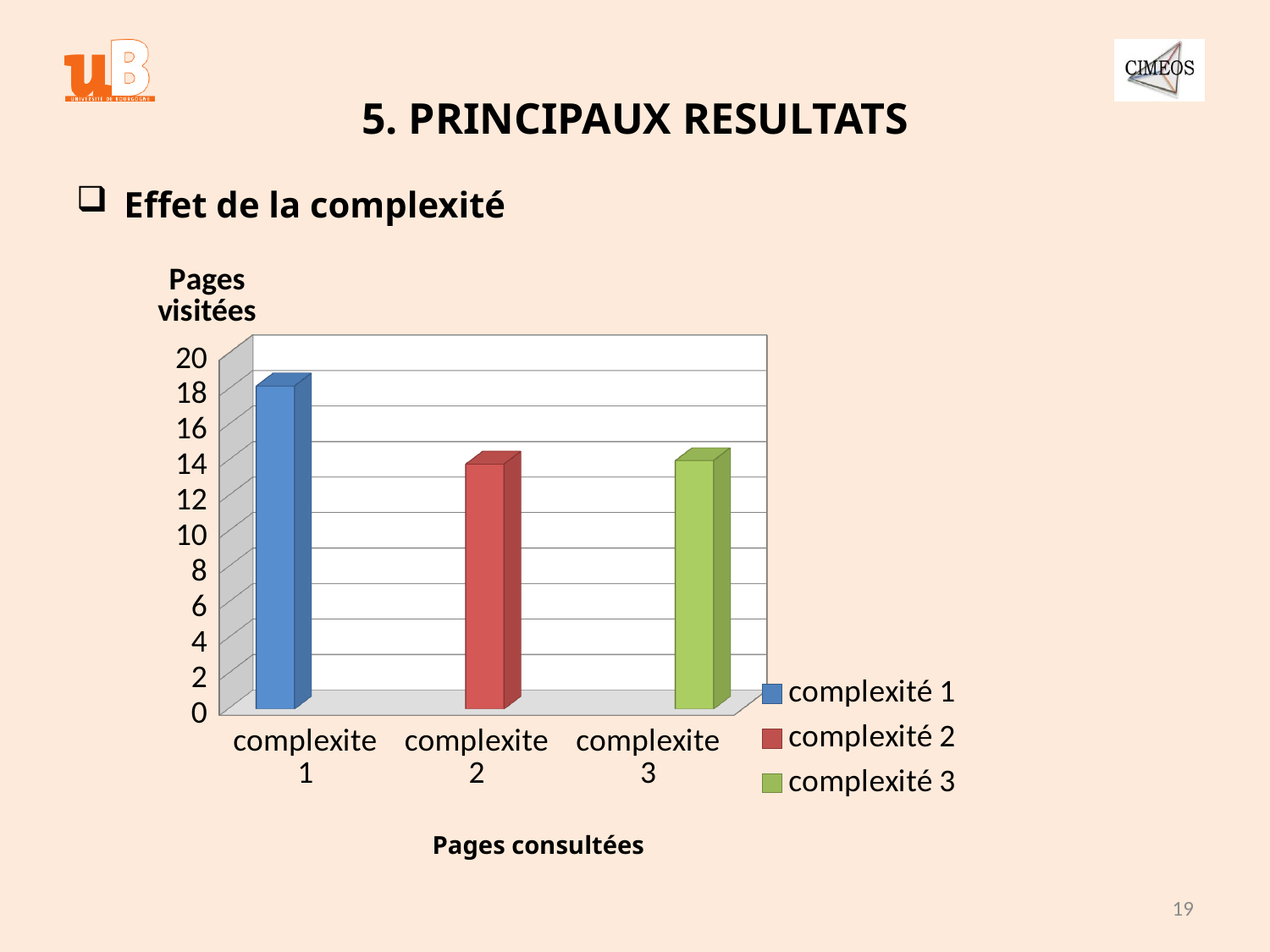
How many entries does the chart's legend list? 3 Is the value for complexite 2 greater or less than 16? less Which is larger, the value for complexite 1 or the value for complexite 3? complexite 1 How many categories are plotted on the x axis of the chart? 3 Is the value for complexite 1 greater or less than 16? greater Is the value for complexite 3 greater or less than 10? greater Which is larger, the value for complexite 1 or the value for complexite 2? complexite 1 What colour is the bar for complexité 2 according to the legend? red What is the title of the vertical axis of the chart? Pages visitées What kind of chart is shown on the slide? bar chart Which category has the highest number of pages visited? complexite 1